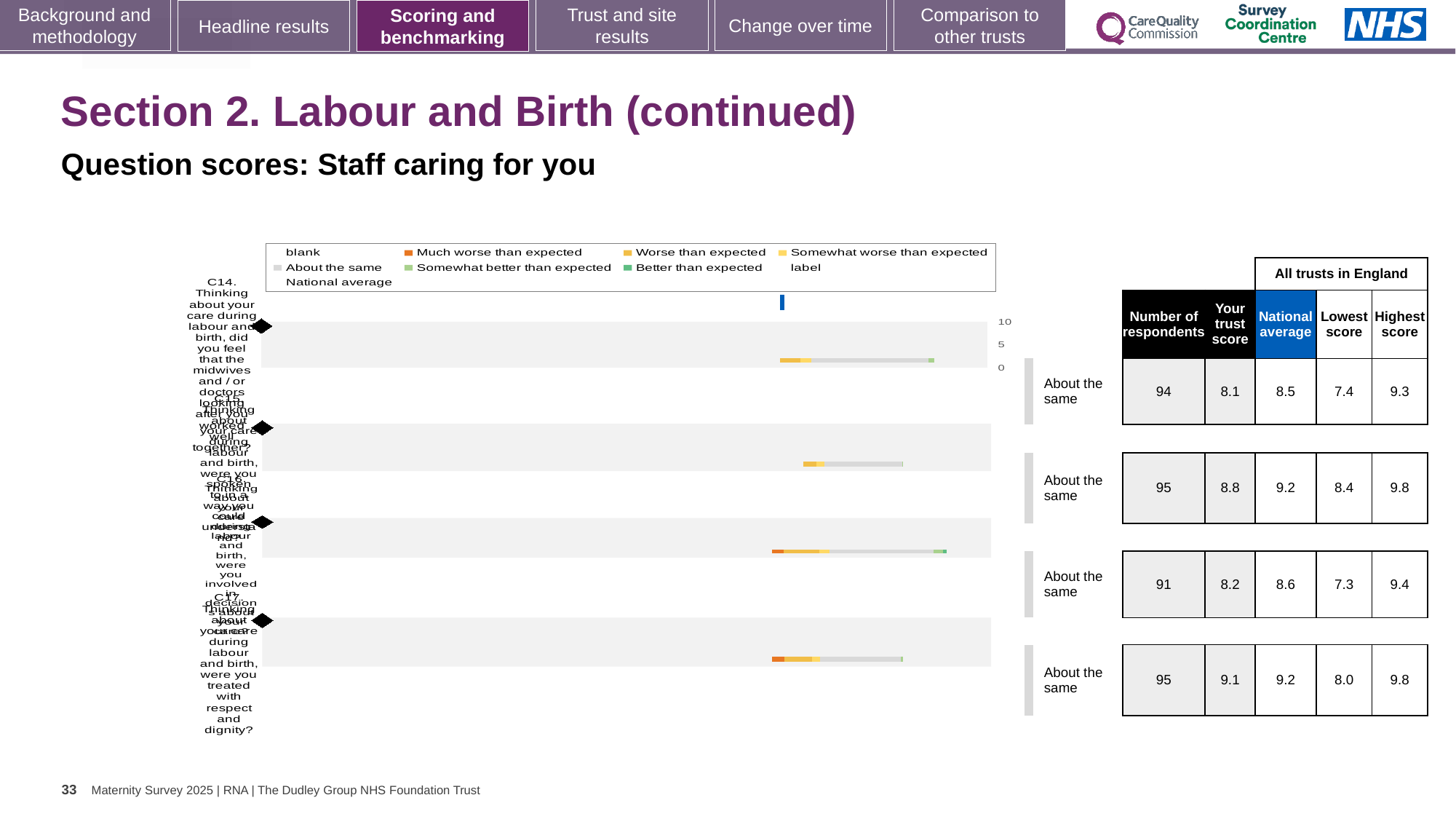
In the first row of the table, which is larger: the trust score or the national average? national average What is the heading above the chart? Question scores: Staff caring for you How many entries does the chart's legend list? 9 In the first row of the table, what is the difference between the national average and the trust score? 0.4 In the table beside the chart, what is the number of respondents in the first row? 94 What kind of chart is shown on the slide? bar chart In the table beside the chart, which row has the highest "Your trust score"? the fourth row (9.1) In the table beside the chart, what is the national average in the second row? 9.2 In the table beside the chart, what is the "Your trust score" value in the first row? 8.1 In the table beside the chart, what is the lowest score in the third row? 7.3 How many question rows (bars) are plotted in the chart? 4 What colour is the legend entry for "Much worse than expected"? orange